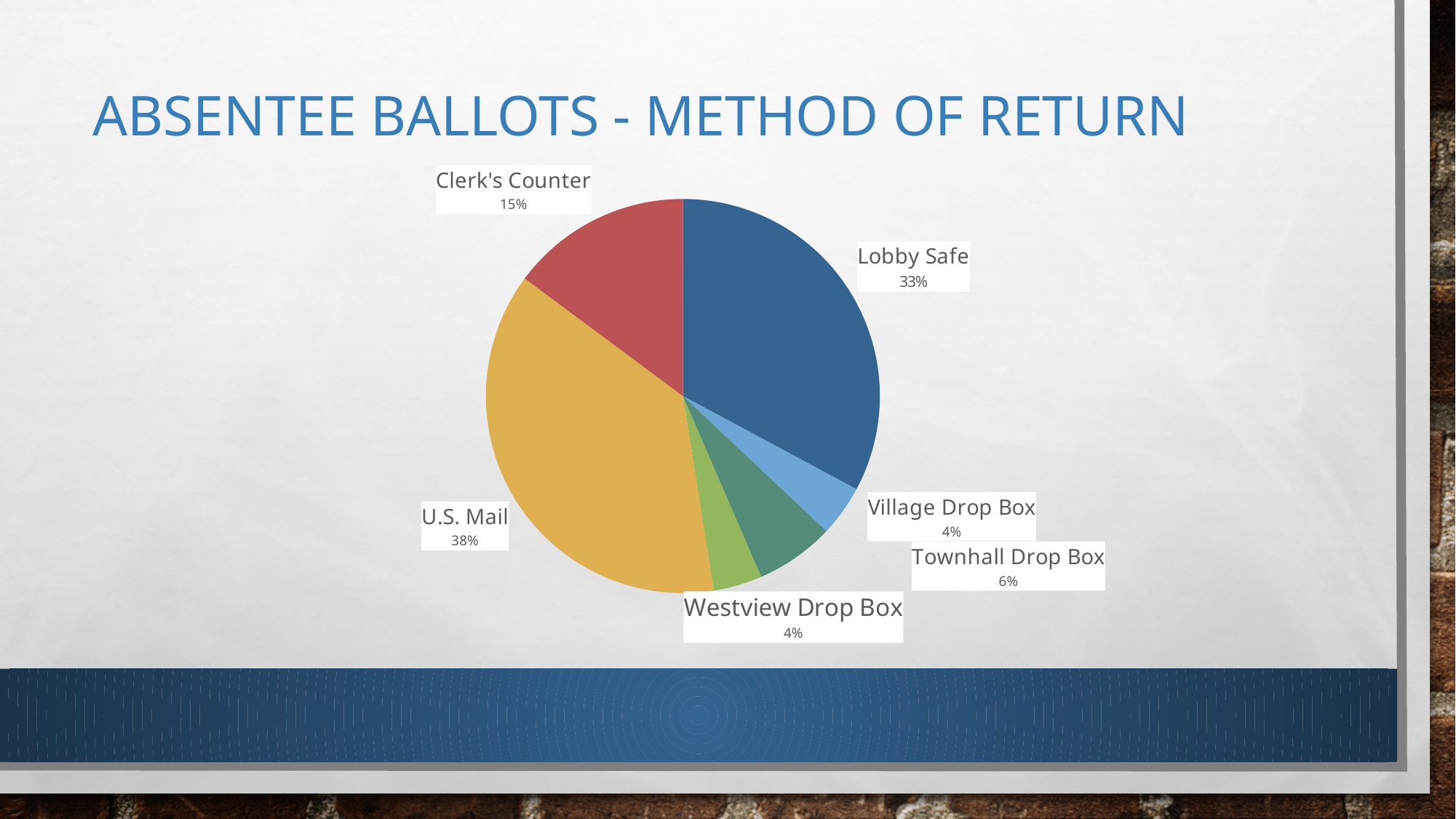
What kind of chart is shown on the slide? Pie chart What is the title of the slide? Absentee Ballots - Method of Return How many methods of return are shown in the pie chart? 6 What colour is the U.S. Mail slice of the pie? Yellow/orange What is the difference in percentage points between U.S. Mail and Lobby Safe? 5 What is the combined share of the Village Drop Box and Westview Drop Box? 8% What share of absentee ballots was returned by U.S. Mail? 38% What percentage of ballots was returned at the Clerk's Counter? 15% What share of absentee ballots was returned via the Lobby Safe? 33% Which method of return has the largest share of the pie? U.S. Mail What share of ballots was returned via the Townhall Drop Box? 6% Which is larger, the share for Clerk's Counter or the share for Townhall Drop Box? Clerk's Counter